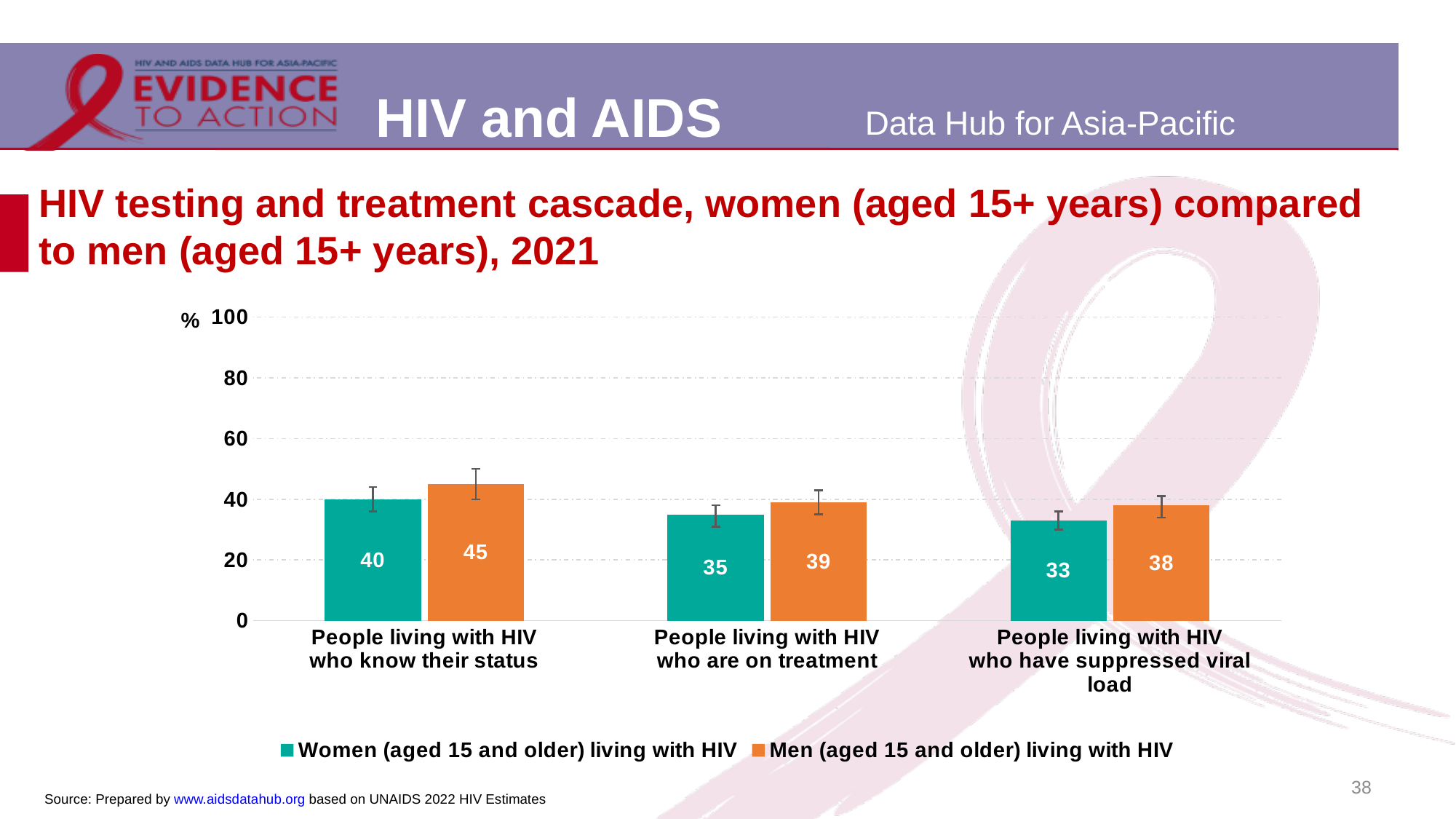
What is the value for men (aged 15 and older) living with HIV who know their status? 45 Which category has the highest value for men (aged 15 and older) living with HIV? People living with HIV who know their status Which category has the lowest value for women (aged 15 and older) living with HIV? People living with HIV who have suppressed viral load How many categories are shown on the x axis? 3 What is the value for women (aged 15 and older) living with HIV who have suppressed viral load? 33 What is the value for men (aged 15 and older) living with HIV who are on treatment? 39 Do the values for women (aged 15 and older) living with HIV rise or fall across the categories from left to right? Fall Which is larger for people living with HIV who have suppressed viral load: the value for women or the value for men? Men What is the difference between the men and women values for people living with HIV who know their status? 5 What is the value for women (aged 15 and older) living with HIV who know their status? 40 How many series does the legend list? 2 What kind of chart is shown on the slide? Bar chart